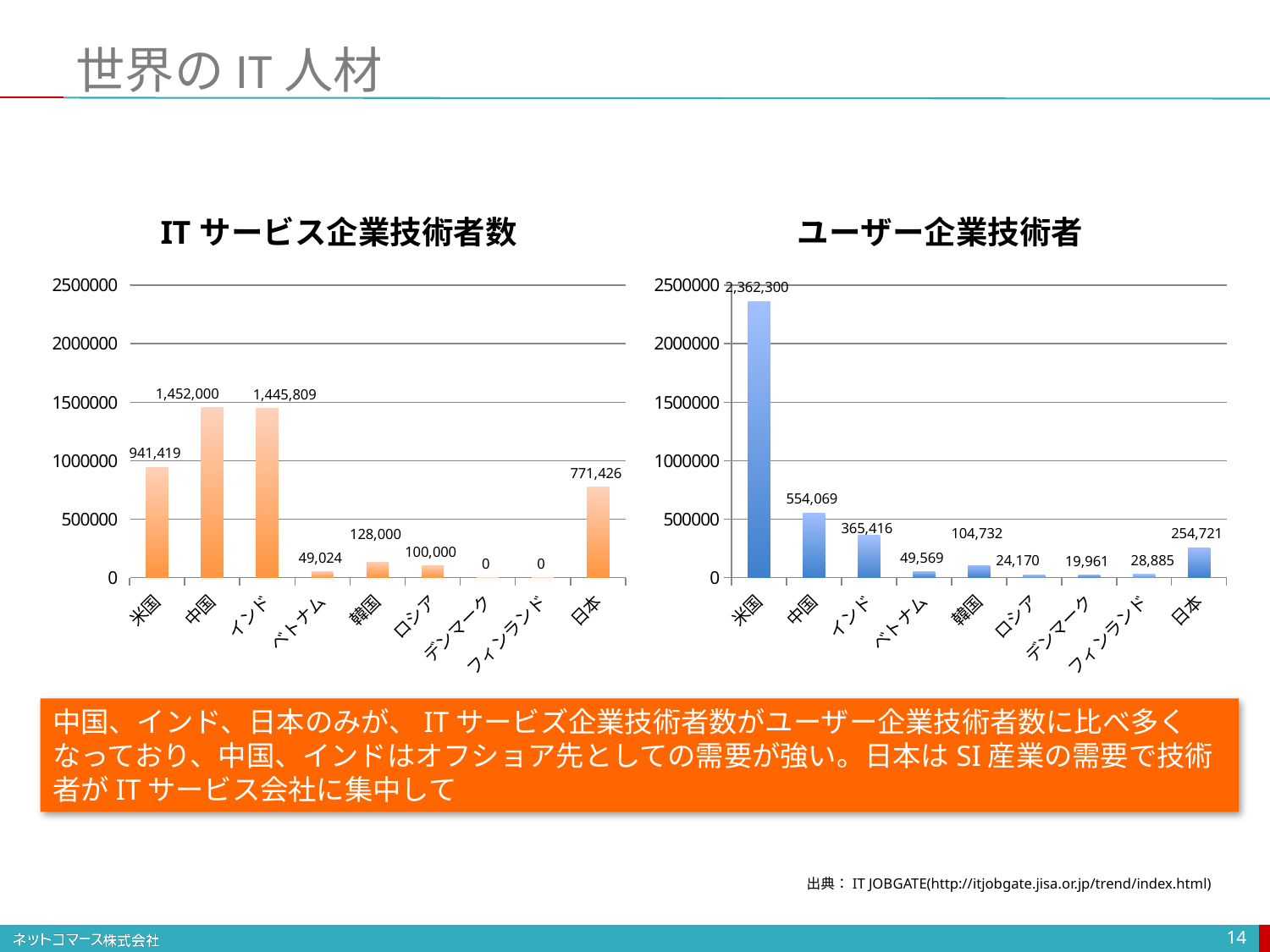
In the ユーザー企業技術者 chart on the right, what is the value for 米国? 2,362,300 How many countries are shown on the x axis of the ITサービス企業技術者数 chart on the left? 9 In the ユーザー企業技術者 chart on the right, which country has the lowest value? デンマーク In the ITサービス企業技術者数 chart on the left, is the value for 米国 greater or less than 500000? greater In the ITサービス企業技術者数 chart on the left, what is the value for 韓国? 128,000 In the ユーザー企業技術者 chart on the right, which is larger, the value for 中国 or the value for 日本? 中国 In the ユーザー企業技術者 chart on the right, which country has the highest value? 米国 In the ITサービス企業技術者数 chart on the left, what is the value for 日本? 771,426 What is the title of the chart on the left? ITサービス企業技術者数 In the ユーザー企業技術者 chart on the right, what is the value for デンマーク? 19,961 What kind of chart is the ユーザー企業技術者 chart on the right? bar chart In the ITサービス企業技術者数 chart on the left, what is the difference between the values for 中国 and インド? 6,191